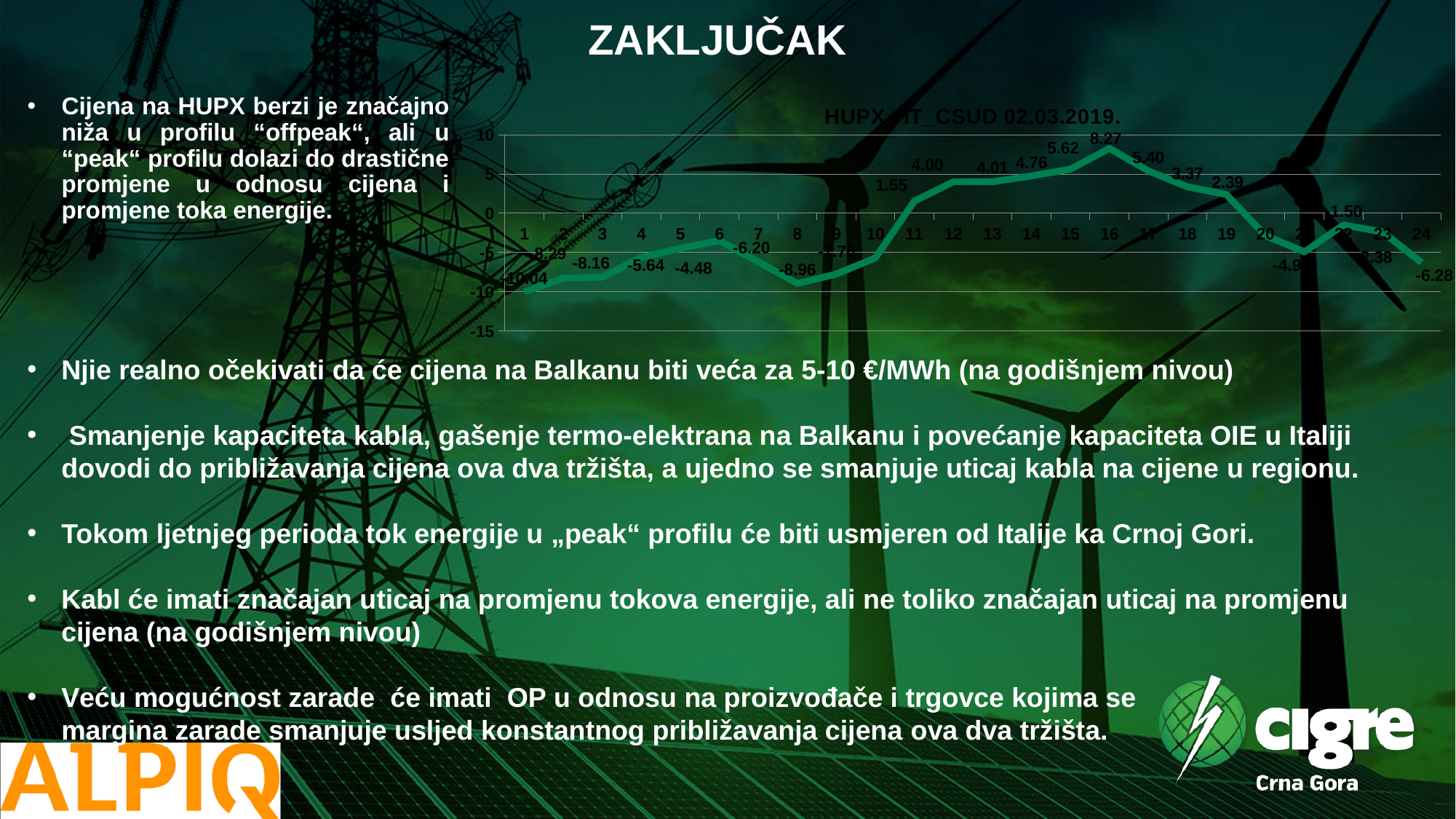
At which hour does the chart reach its highest value? 16 At which hour does the chart reach its lowest value? 1 What is the value at hour 24 in the chart? -6.28 What is the value at hour 16 in the chart? 8.27 Which is larger, the value at hour 15 or the value at hour 18? hour 15 How many points (hours) are plotted along the x axis of the chart? 24 What kind of chart is shown on the slide? line chart What is the value at hour 11 in the chart? 1.55 What is the title of the chart? HUPX - IT_CSUD 02.03.2019. Is the value at hour 16 greater or less than 5? greater What is the value at hour 1 in the chart? -10.04 What is the difference between the values at hour 16 and hour 17? 2.87